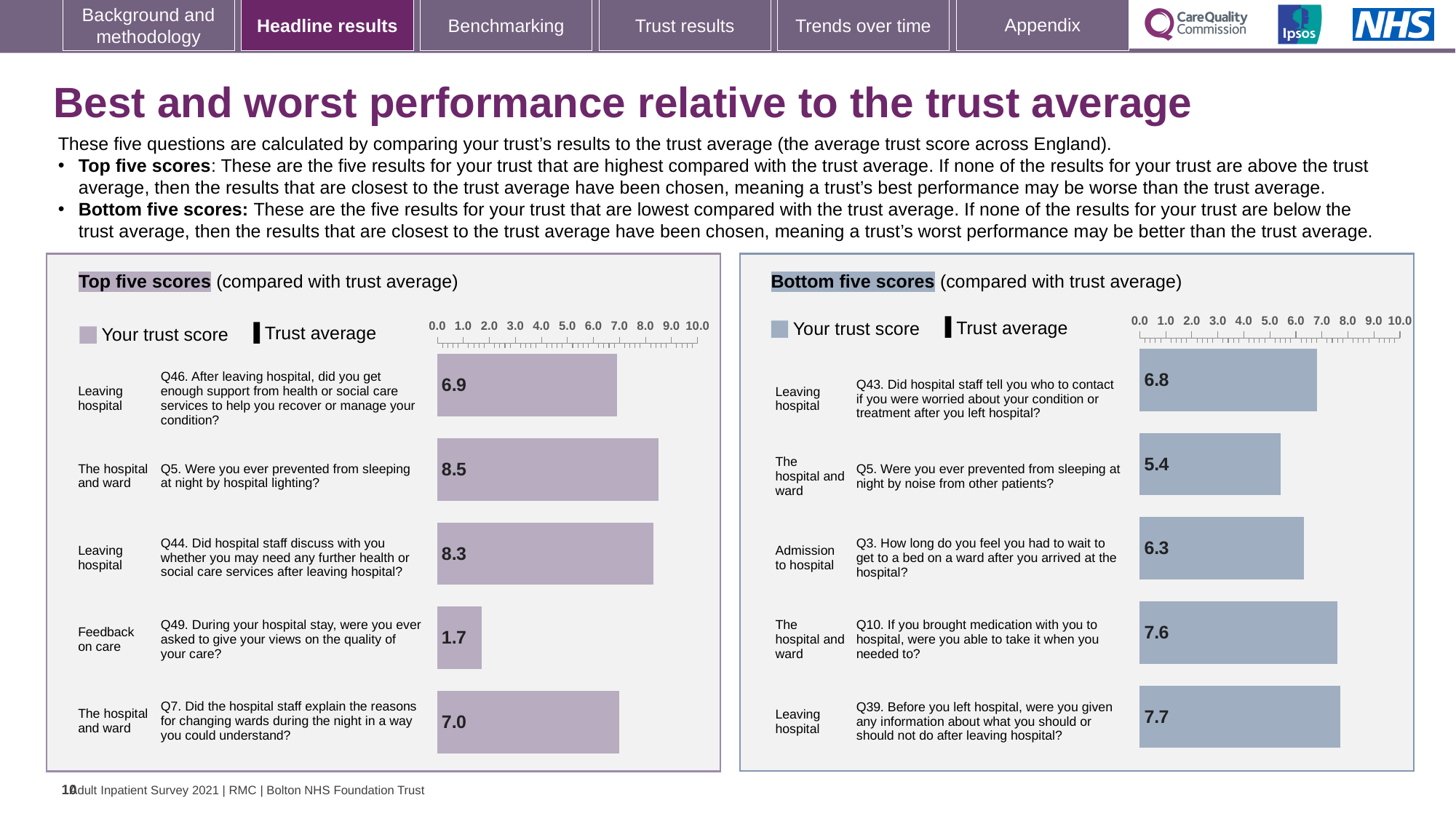
In the Bottom five scores chart, what is the difference between the score for Q39 and the score for Q5? 2.3 In the Bottom five scores chart, what is the trust score for Q39 about being given information about what you should or should not do after leaving hospital? 7.7 In the Bottom five scores chart, which question has the lowest trust score? Q5. Were you ever prevented from sleeping at night by noise from other patients? How many questions are shown in the Bottom five scores chart? 5 In the Top five scores chart, what is the trust score for Q46 about getting enough support from health or social care services after leaving hospital? 6.9 In the Top five scores chart, which question has the highest trust score? Q5. Were you ever prevented from sleeping at night by hospital lighting? In the Top five scores chart, what is the difference between the highest score (Q5) and the lowest score (Q49)? 6.8 In the Bottom five scores chart, what is the trust score for Q3 about how long you had to wait to get to a bed on a ward? 6.3 How many entries does the legend of the Bottom five scores chart list? 2 What type of chart is used in the Top five scores panel? Bar chart In the Top five scores chart, what is the trust score for Q49 about being asked to give your views on the quality of your care? 1.7 In the Top five scores chart, which has the larger trust score: Q44 or Q7? Q44